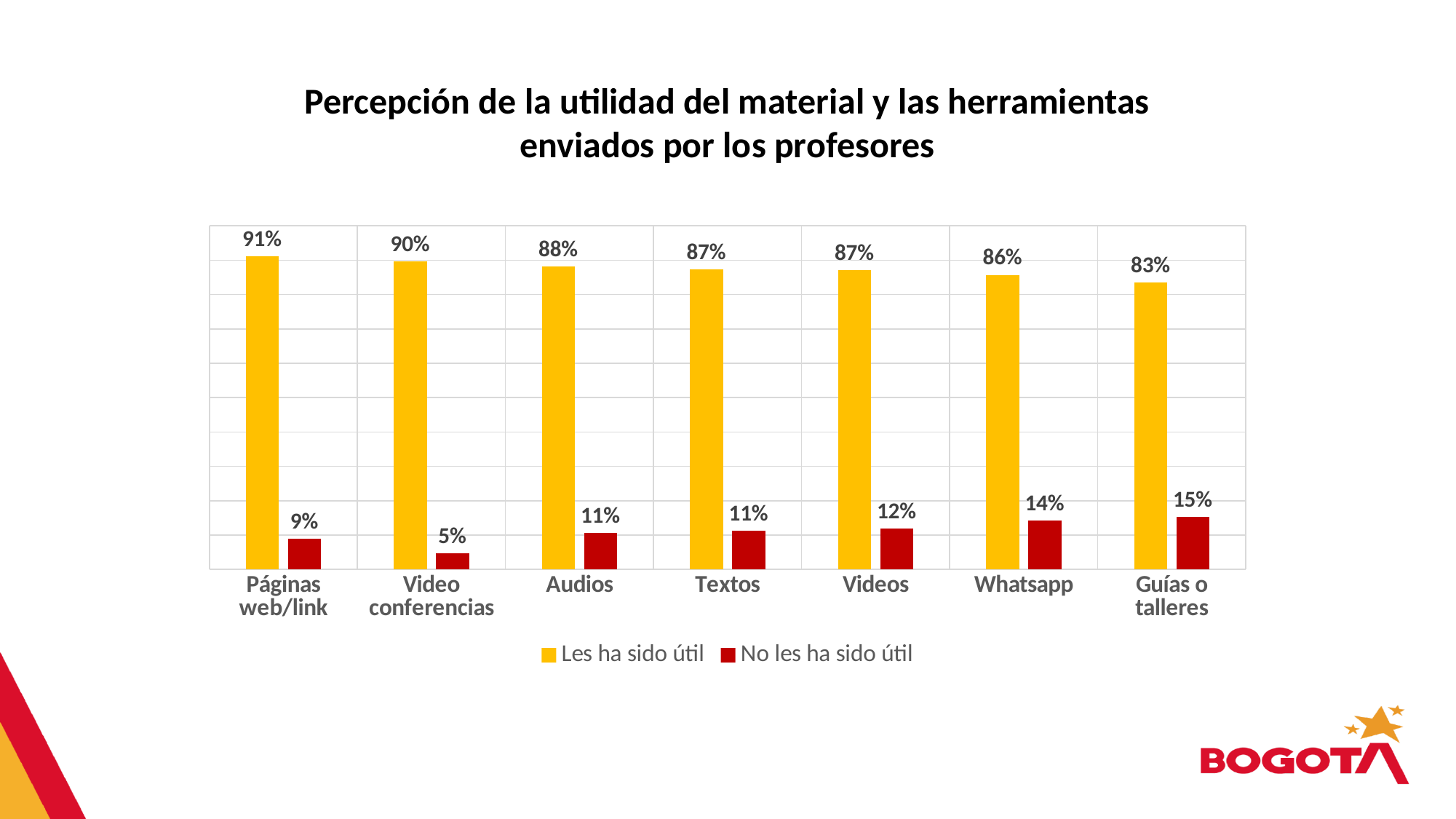
What is the value for "No les ha sido útil" for Video conferencias? 5% What is the difference between the "Les ha sido útil" values for Páginas web/link and Guías o talleres? 8% Which category has the lowest value for "No les ha sido útil"? Video conferencias Which colour represents the "No les ha sido útil" series? Red Which category has the lowest value for "Les ha sido útil"? Guías o talleres Which is larger: the "No les ha sido útil" value for Whatsapp or for Audios? Whatsapp What is the value for "No les ha sido útil" for Guías o talleres? 15% What kind of chart is shown on the slide? Bar chart Which category has the highest value for "Les ha sido útil"? Páginas web/link How many categories are shown on the x axis? 7 What is the value for "Les ha sido útil" for Páginas web/link? 91% How many series does the legend list? 2